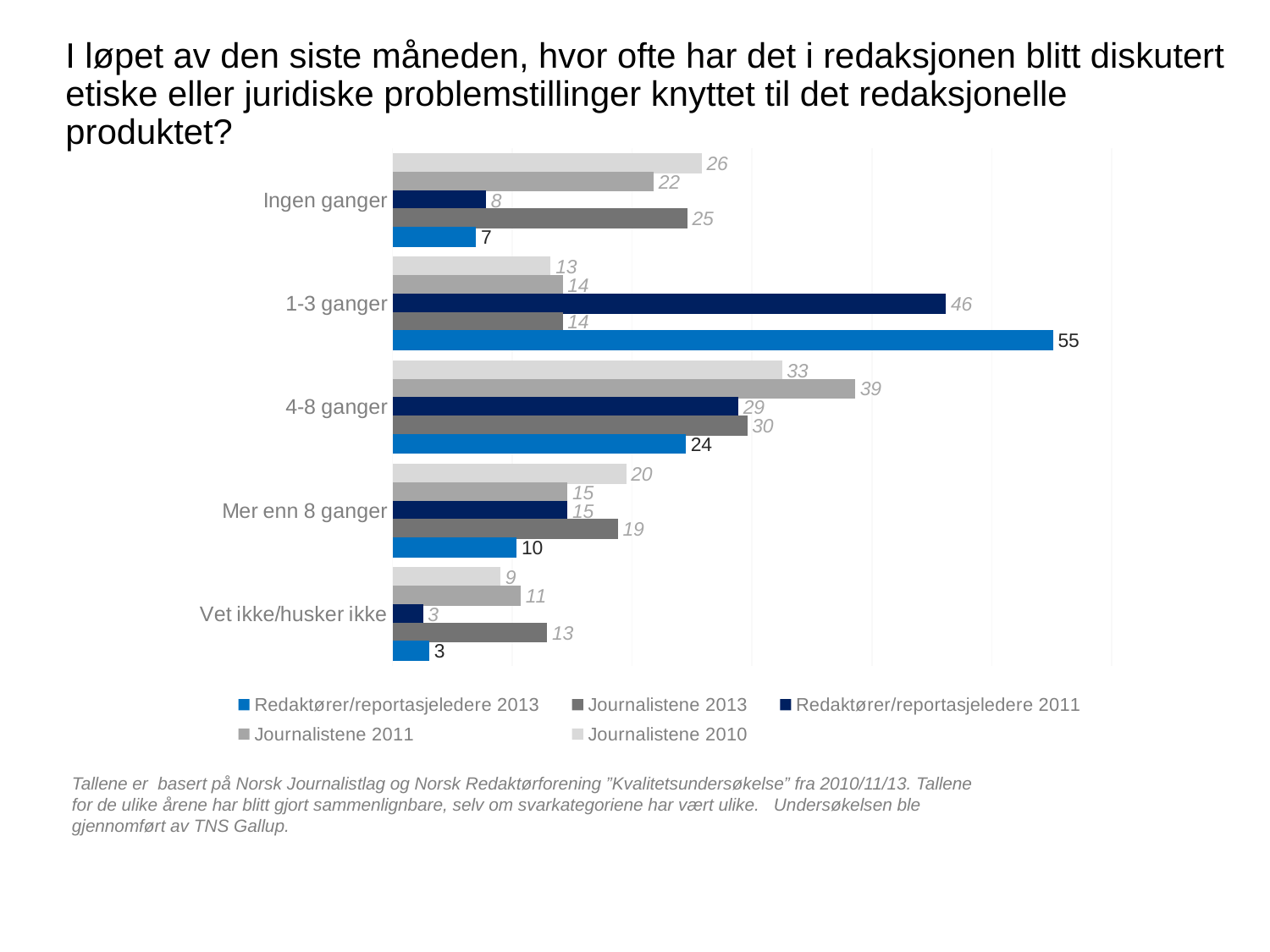
In the '4-8 ganger' category, which is larger: Journalistene 2011 or Journalistene 2010? Journalistene 2011 What is the value for Journalistene 2010 in the 'Ingen ganger' category? 26 Which category has the lowest value for Redaktører/reportasjeledere 2011? Vet ikke/husker ikke How many categories are shown on the chart? 5 Which category has the highest value for Redaktører/reportasjeledere 2013? 1-3 ganger What is the value for Redaktører/reportasjeledere 2013 in the '1-3 ganger' category? 55 How many series does the legend list? 5 What is the value for Journalistene 2013 in the 'Vet ikke/husker ikke' category? 13 What kind of chart is shown on the slide? Bar chart What is the difference between Redaktører/reportasjeledere 2013 and Redaktører/reportasjeledere 2011 in the '1-3 ganger' category? 9 What is the value for Redaktører/reportasjeledere 2011 in the '4-8 ganger' category? 29 Which series is shown in light blue on the chart? Redaktører/reportasjeledere 2013